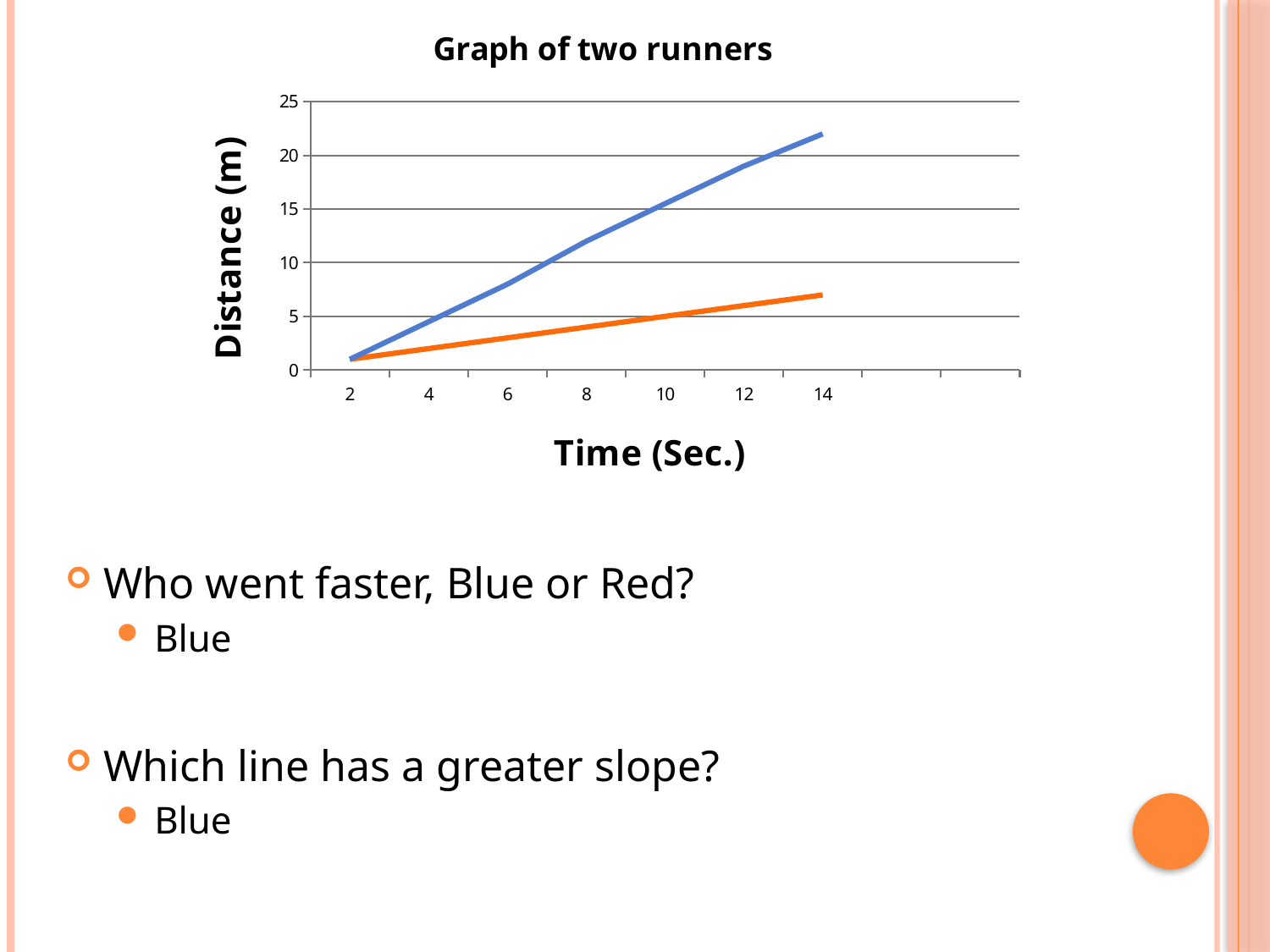
What is the title of the chart? Graph of two runners Is the value of the blue line at time 8 greater or less than 10? greater Does the orange line rise or fall as time increases? rise Is the value of the blue line at time 14 greater or less than 20? greater What kind of chart is shown on the slide? line chart How many lines are plotted on the chart? 2 At time 14, which line is higher, the blue line or the orange line? blue line Is the value of the orange line at time 8 greater or less than 5? less Which line has the steeper slope, the blue line or the orange line? blue line What is the label of the y axis? Distance (m) Does the blue line rise or fall as time increases? rise